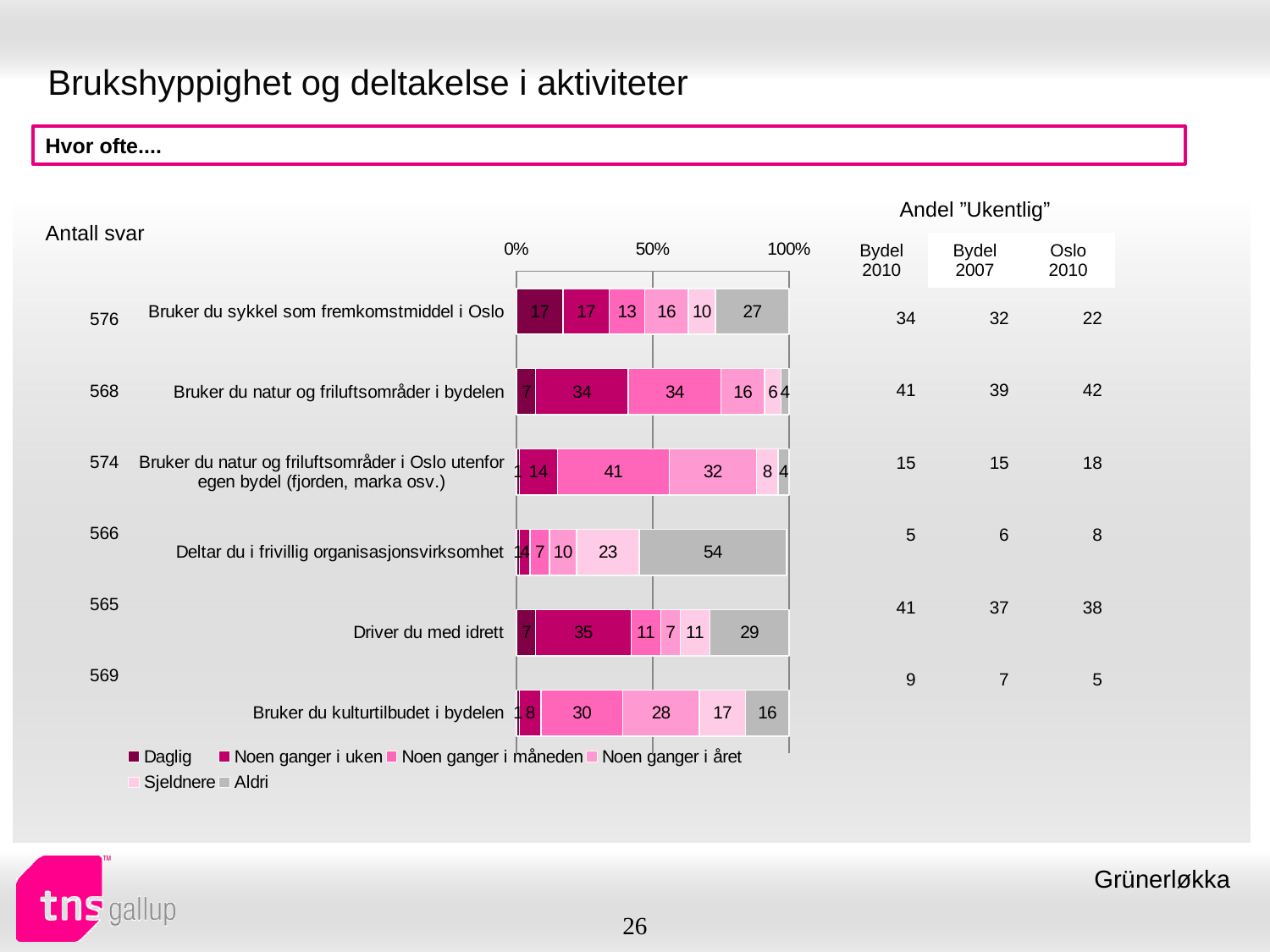
Which has the larger 'Noen ganger i uken' value: 'Bruker du natur og friluftsområder i bydelen' or 'Driver du med idrett'? Driver du med idrett Which category has the highest 'Aldri' value? Deltar du i frivillig organisasjonsvirksomhet How many series does the legend of the bar chart list? 6 What is the 'Aldri' value for 'Deltar du i frivillig organisasjonsvirksomhet'? 54 What is the 'Noen ganger i uken' value for 'Driver du med idrett'? 35 How many activity categories are plotted in the bar chart? 6 What is the 'Daglig' value for 'Bruker du sykkel som fremkomstmiddel i Oslo'? 17 What is the first entry in the chart's legend? Daglig What is the difference between the 'Aldri' values for 'Driver du med idrett' and 'Bruker du sykkel som fremkomstmiddel i Oslo'? 2 What is the 'Sjeldnere' value for 'Bruker du kulturtilbudet i bydelen'? 17 What kind of chart is shown on the slide? Stacked bar chart What is the 'Noen ganger i måneden' value for 'Bruker du natur og friluftsområder i Oslo utenfor egen bydel (fjorden, marka osv.)'? 41